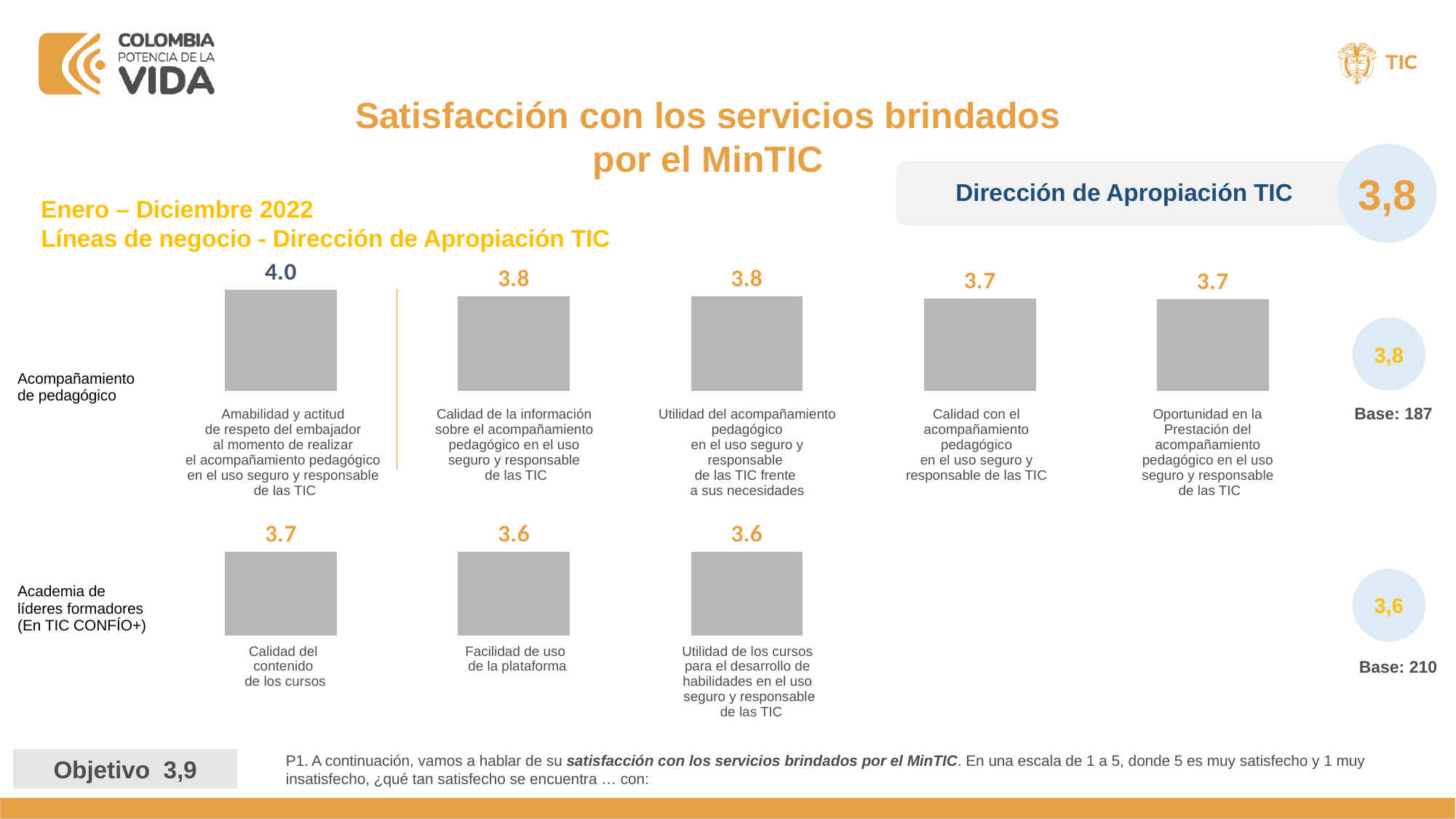
In the Academia de líderes formadores (En TIC CONFÍO+) chart, which category has the highest value? Calidad del contenido de los cursos In the Acompañamiento de pedagógico chart, what is the difference between the value for 'Amabilidad y actitud de respeto del embajador...' and the value for 'Calidad con el acompañamiento pedagógico en el uso seguro y responsable de las TIC'? 0.3 In the Acompañamiento de pedagógico chart, which is larger: the value for 'Calidad de la información sobre el acompañamiento pedagógico en el uso seguro y responsable de las TIC' or the value for 'Calidad con el acompañamiento pedagógico en el uso seguro y responsable de las TIC'? Calidad de la información sobre el acompañamiento pedagógico en el uso seguro y responsable de las TIC How many categories are shown in the Academia de líderes formadores (En TIC CONFÍO+) chart? 3 In the Academia de líderes formadores (En TIC CONFÍO+) chart, what is the value for 'Calidad del contenido de los cursos'? 3.7 In the Acompañamiento de pedagógico chart, which category has the highest value? Amabilidad y actitud de respeto del embajador al momento de realizar el acompañamiento pedagógico en el uso seguro y responsable de las TIC In the Acompañamiento de pedagógico chart, what is the value for 'Oportunidad en la Prestación del acompañamiento pedagógico en el uso seguro y responsable de las TIC'? 3.7 In the Academia de líderes formadores (En TIC CONFÍO+) chart, what is the difference between the value for 'Calidad del contenido de los cursos' and the value for 'Utilidad de los cursos para el desarrollo de habilidades en el uso seguro y responsable de las TIC'? 0.1 What kind of chart is used for the Acompañamiento de pedagógico data? Bar chart In the Acompañamiento de pedagógico chart, what is the value for 'Amabilidad y actitud de respeto del embajador al momento de realizar el acompañamiento pedagógico en el uso seguro y responsable de las TIC'? 4.0 How many categories are shown in the Acompañamiento de pedagógico chart? 5 In the Academia de líderes formadores (En TIC CONFÍO+) chart, what is the value for 'Facilidad de uso de la plataforma'? 3.6